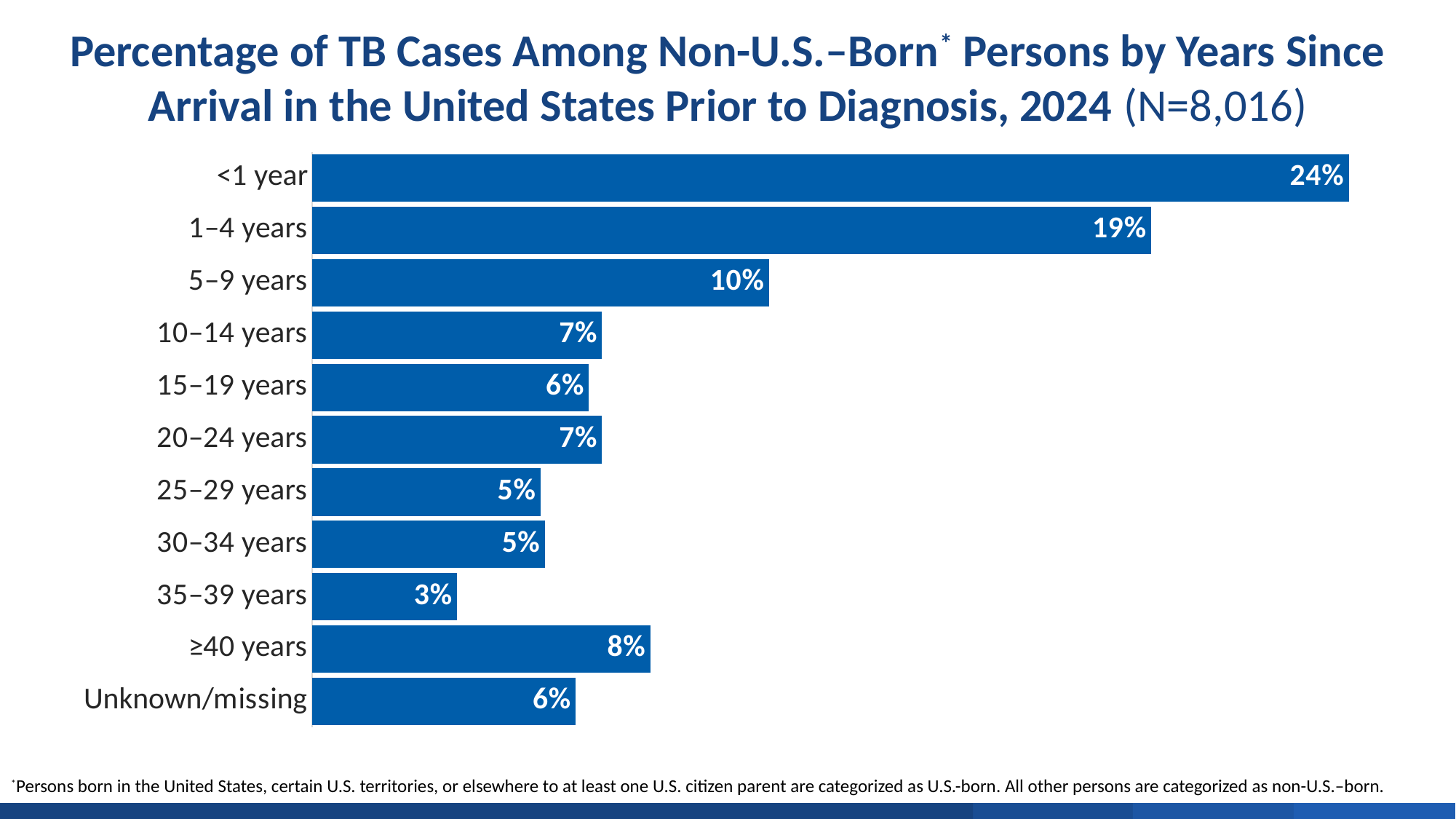
What is the N value given in the chart title? N=8,016 What is the value for the 5–9 years category? 10% What kind of chart is shown on the slide? Bar chart What is the value for Unknown/missing? 6% Which category has the lowest percentage? 35–39 years What percentage is shown for the ≥40 years category? 8% What percentage of TB cases among non-U.S.-born persons were diagnosed less than 1 year after arrival? 24% How many categories are shown in the chart? 11 Which category has the highest percentage? <1 year What is the difference between the <1 year and 1–4 years values? 5% Which is larger, the value for 10–14 years or the value for 25–29 years? 10–14 years What is the difference between the 5–9 years and 35–39 years values? 7%